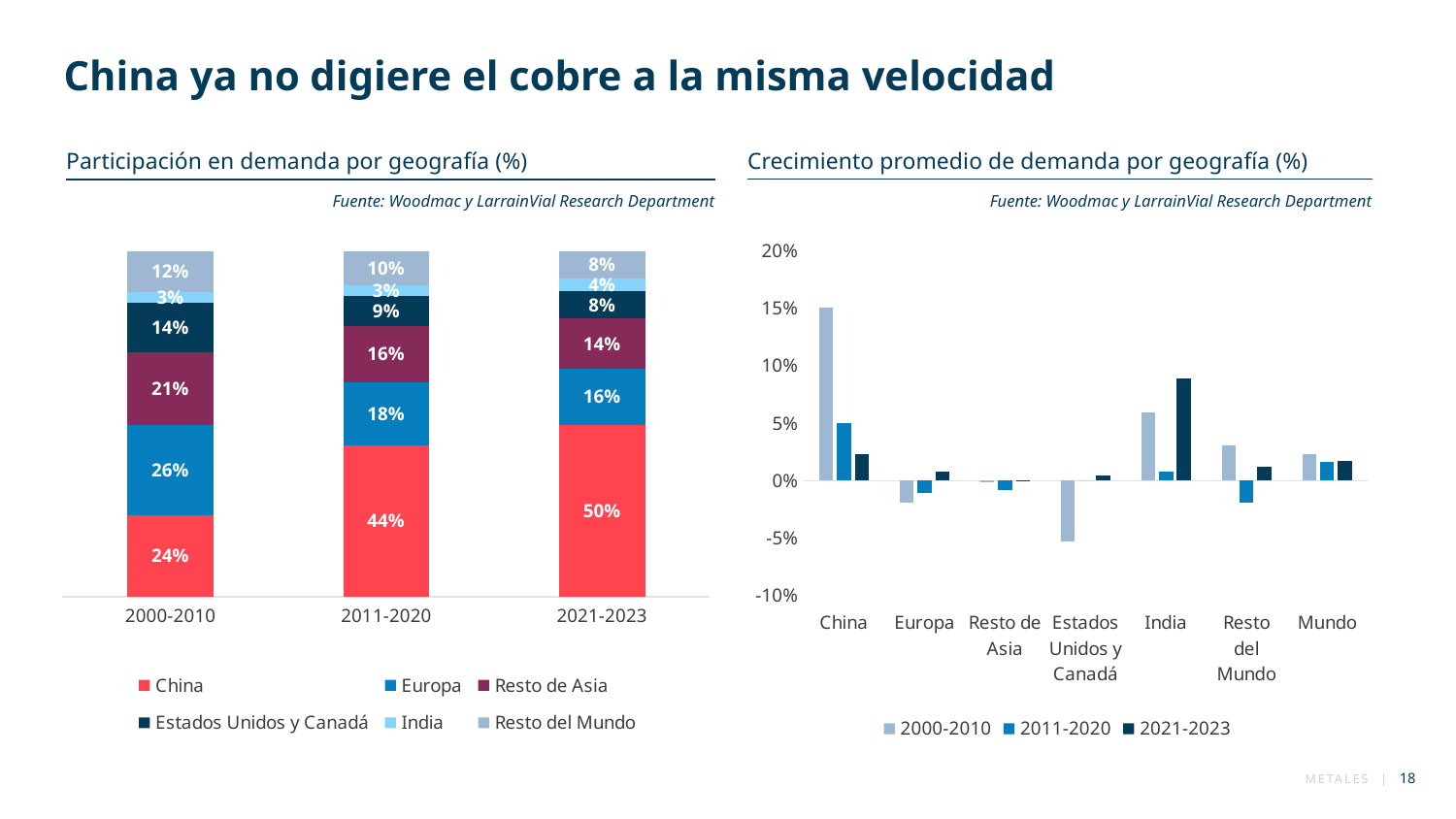
In the chart 'Participación en demanda por geografía (%)', which is larger in 2000-2010: China or Europa? Europa What kind of chart is 'Crecimiento promedio de demanda por geografía (%)'? bar chart In the chart 'Crecimiento promedio de demanda por geografía (%)', is the value for China in 2000-2010 greater or less than 10%? greater In the chart 'Participación en demanda por geografía (%)', how many series does the legend list? 6 In the chart 'Participación en demanda por geografía (%)', what is the value for China in 2021-2023? 50% In the chart 'Participación en demanda por geografía (%)', by how much did China's share increase from 2000-2010 to 2021-2023? 26% In the chart 'Crecimiento promedio de demanda por geografía (%)', is the value for Estados Unidos y Canadá in 2000-2010 greater or less than 0%? less In the chart 'Crecimiento promedio de demanda por geografía (%)', how many categories are shown on the x axis? 7 In the chart 'Participación en demanda por geografía (%)', what is the value for Europa in 2000-2010? 26% In the chart 'Participación en demanda por geografía (%)', what is the value for Resto de Asia in 2011-2020? 16% In the chart 'Crecimiento promedio de demanda por geografía (%)', which category has the highest value for 2021-2023? India In the chart 'Participación en demanda por geografía (%)', does China's share rise or fall across the three periods? rise